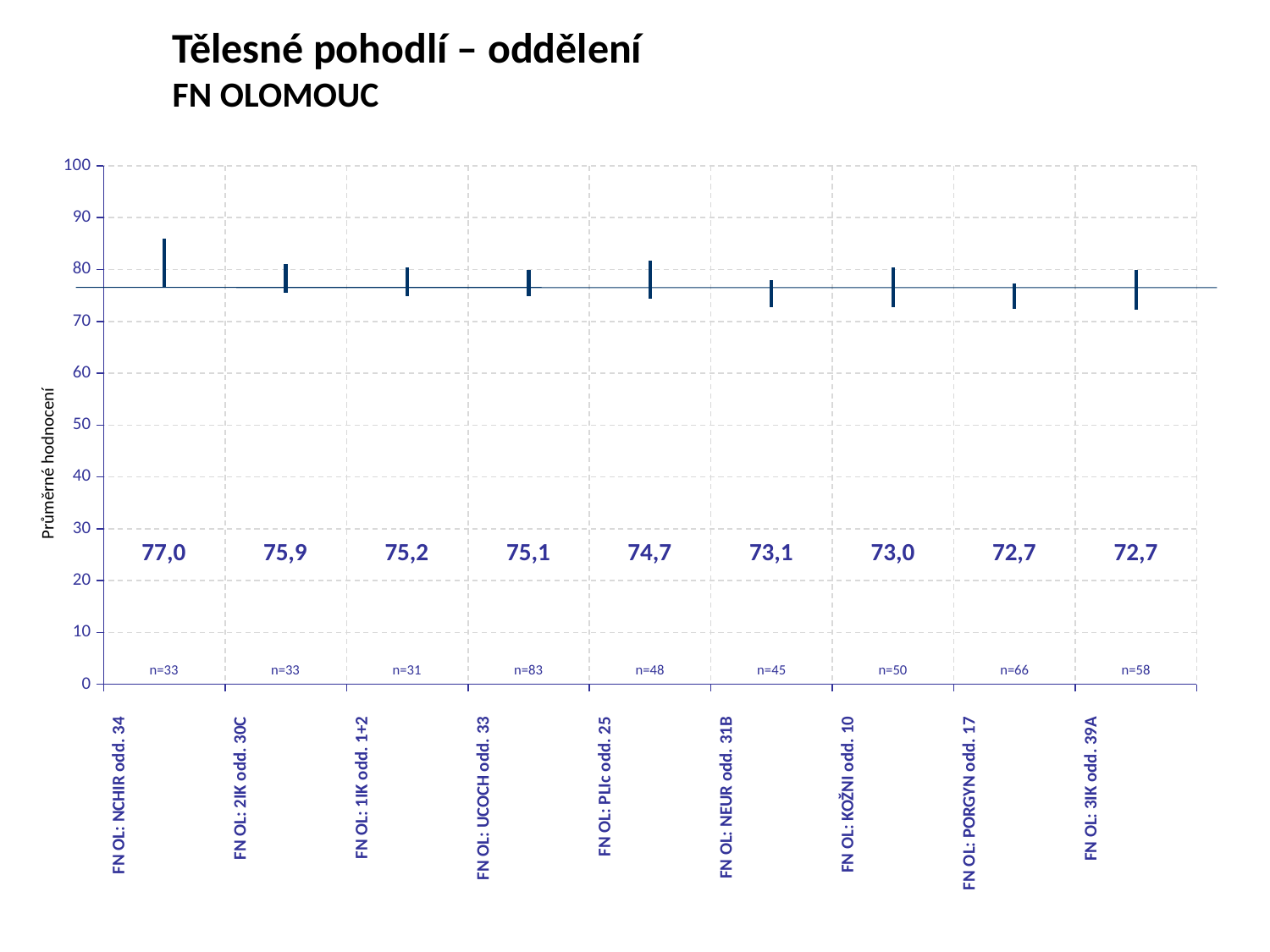
What is the lowest average rating shown on the chart? 72,7 What is the average rating for FN OL: KOŽNI odd. 10? 73,0 Do the average ratings rise or fall from left to right along the x axis? fall Which department has the highest average rating? FN OL: NCHIR odd. 34 How many departments are shown on the chart? 9 What is the difference between the average ratings of FN OL: 2IK odd. 30C and FN OL: 1IK odd. 1+2? 0,7 What is the label of the vertical axis? Průměrné hodnocení Which has a higher average rating, FN OL: 2IK odd. 30C or FN OL: PLIc odd. 25? FN OL: 2IK odd. 30C What is the average rating for FN OL: UCOCH odd. 33? 75,1 What is the average rating (průměrné hodnocení) for FN OL: NCHIR odd. 34? 77,0 What is the difference between the average ratings of FN OL: NCHIR odd. 34 and FN OL: NEUR odd. 31B? 3,9 What is the number of respondents (n) for FN OL: UCOCH odd. 33? n=83